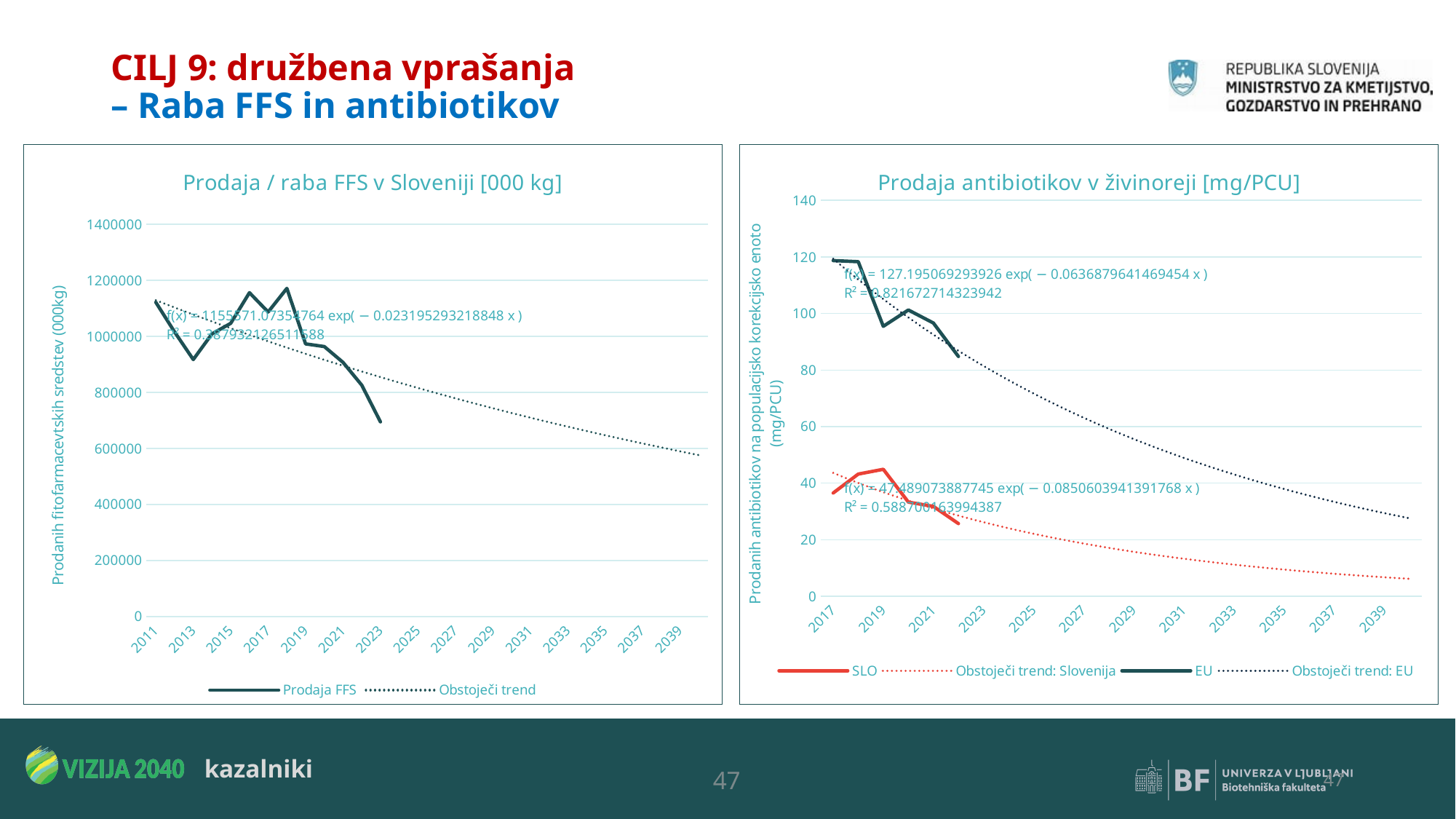
In the right chart 'Prodaja antibiotikov v živinoreji', which series has the higher value in 2017, EU or SLO? EU What kind of chart is the left chart, 'Prodaja / raba FFS v Sloveniji [000 kg]'? line chart What is the title of the right chart on the slide? Prodaja antibiotikov v živinoreji [mg/PCU] In the right chart 'Prodaja antibiotikov v živinoreji', is the EU value for 2017 greater or less than 100? greater In the left chart 'Prodaja / raba FFS v Sloveniji', does the 'Obstoječi trend' line rise or fall from 2011 to 2039? fall In the left chart 'Prodaja / raba FFS v Sloveniji', is the 'Prodaja FFS' value for 2023 greater or less than 800000? less In the right chart 'Prodaja antibiotikov v živinoreji', does the EU line rise or fall from 2017 to 2022? fall How many series does the legend of the right chart 'Prodaja antibiotikov v živinoreji' list? 4 In the right chart 'Prodaja antibiotikov v živinoreji', is the SLO value for 2022 greater or less than 40? less How many series does the legend of the left chart 'Prodaja / raba FFS v Sloveniji' list? 2 What kind of chart is the right chart, 'Prodaja antibiotikov v živinoreji [mg/PCU]'? line chart